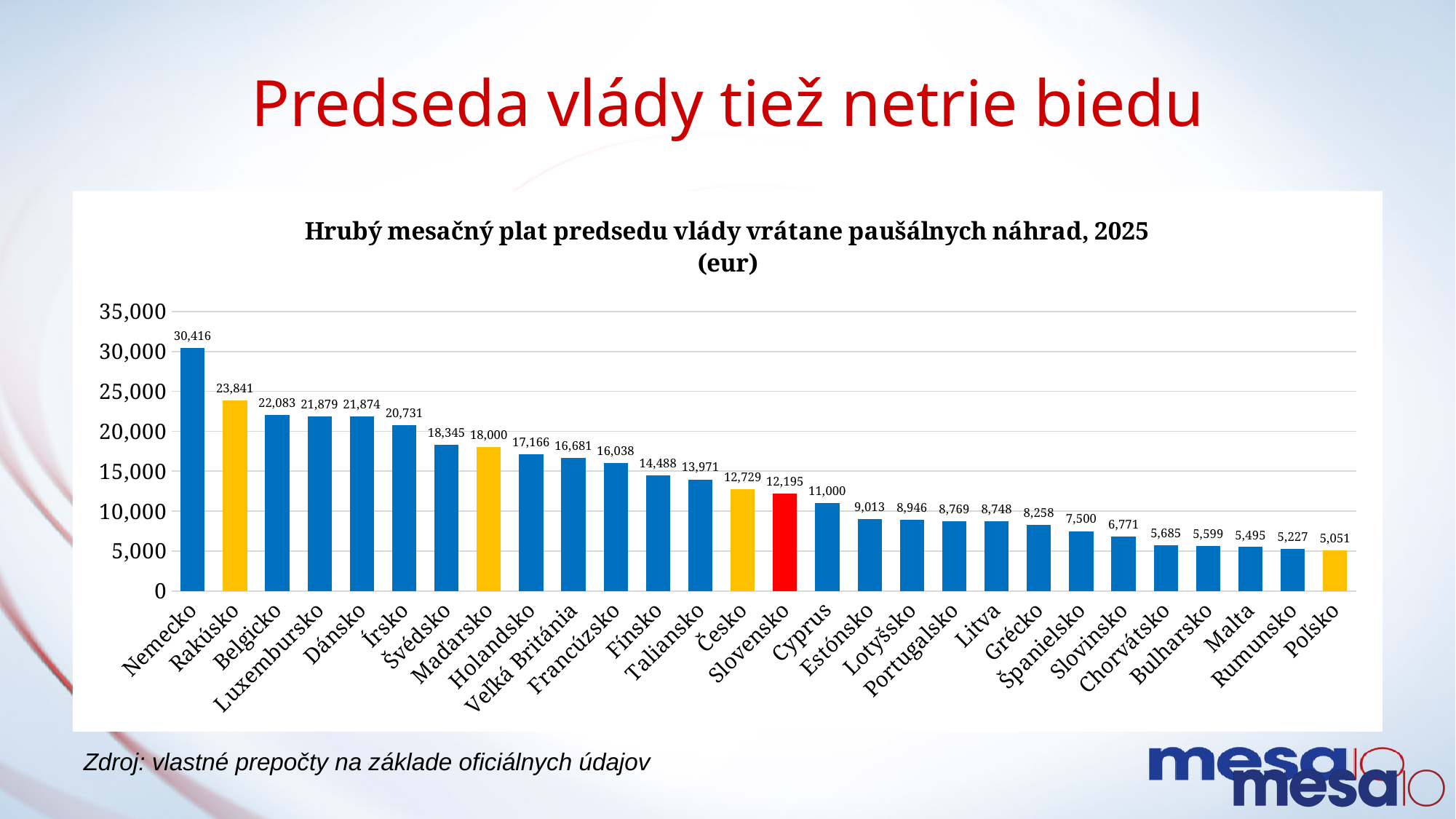
What is the difference between the values for Nemecko and Slovensko? 18,221 How many countries are shown on the chart? 28 Which country has the highest value? Nemecko What is the value for Poľsko? 5,051 What is the difference between the values for Česko and Slovensko? 534 What kind of chart is shown on the slide? bar chart Which country has the lowest value? Poľsko What is the value for Slovensko? 12,195 What is the value for Nemecko? 30,416 Which country's bar is coloured red? Slovensko What is the value for Maďarsko? 18,000 Which is larger, the value for Rakúsko or the value for Belgicko? Rakúsko